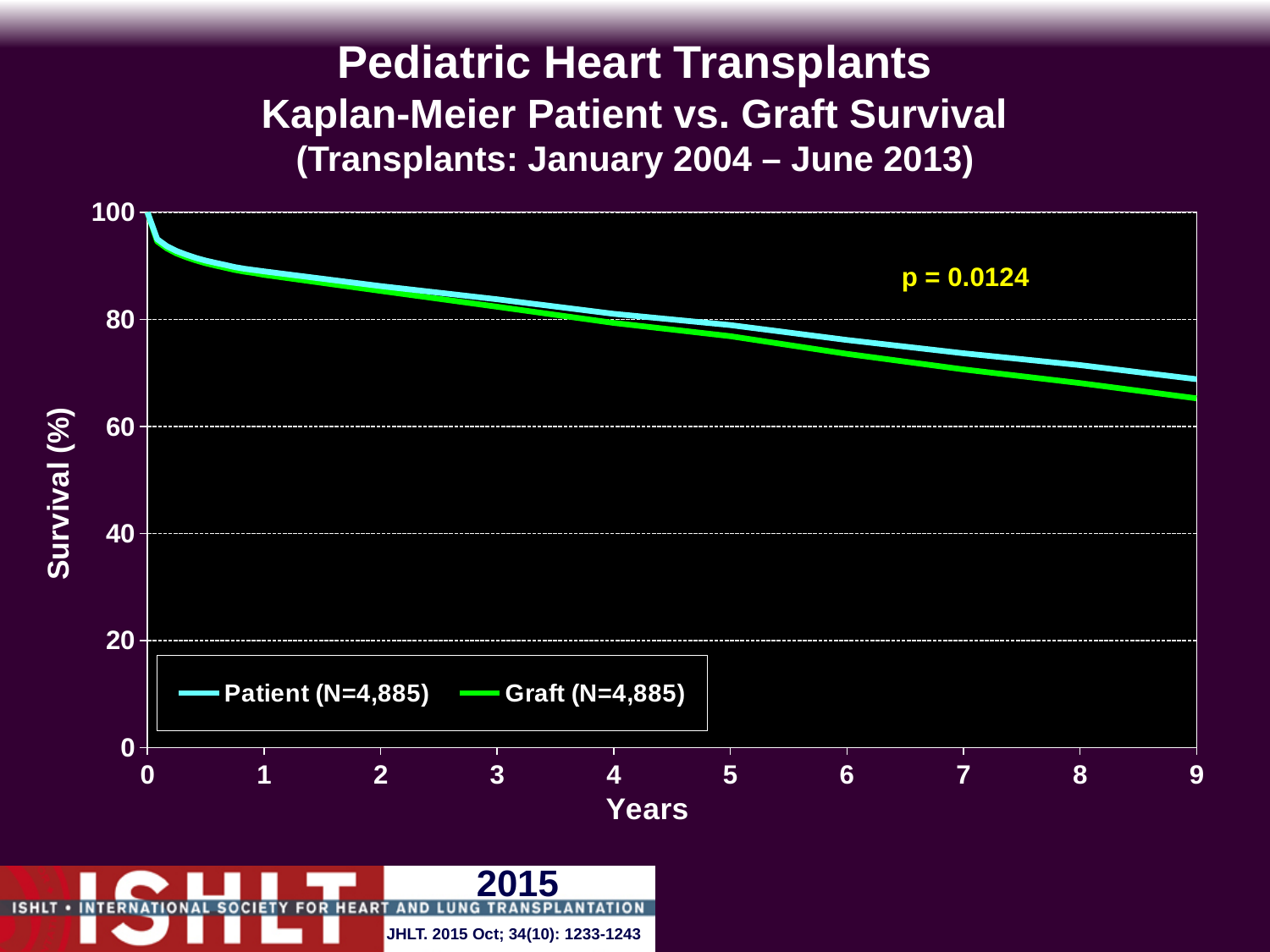
What is the maximum value shown on the y axis? 100 What p-value is printed on the chart? p = 0.0124 At 9 years, which curve is higher, Patient or Graft? Patient How many series does the legend list? 2 Do the survival curves rise or fall as years increase? Fall Is the Patient survival value at 9 years greater or less than 60? greater Is the Patient survival value at 1 year greater or less than 80? greater How many year tick marks are labeled on the x axis? 10 Is the Graft survival value at 9 years greater or less than 60? greater Which two series are plotted in the chart? Patient (N=4,885) and Graft (N=4,885) What kind of chart is shown on the slide? Line chart